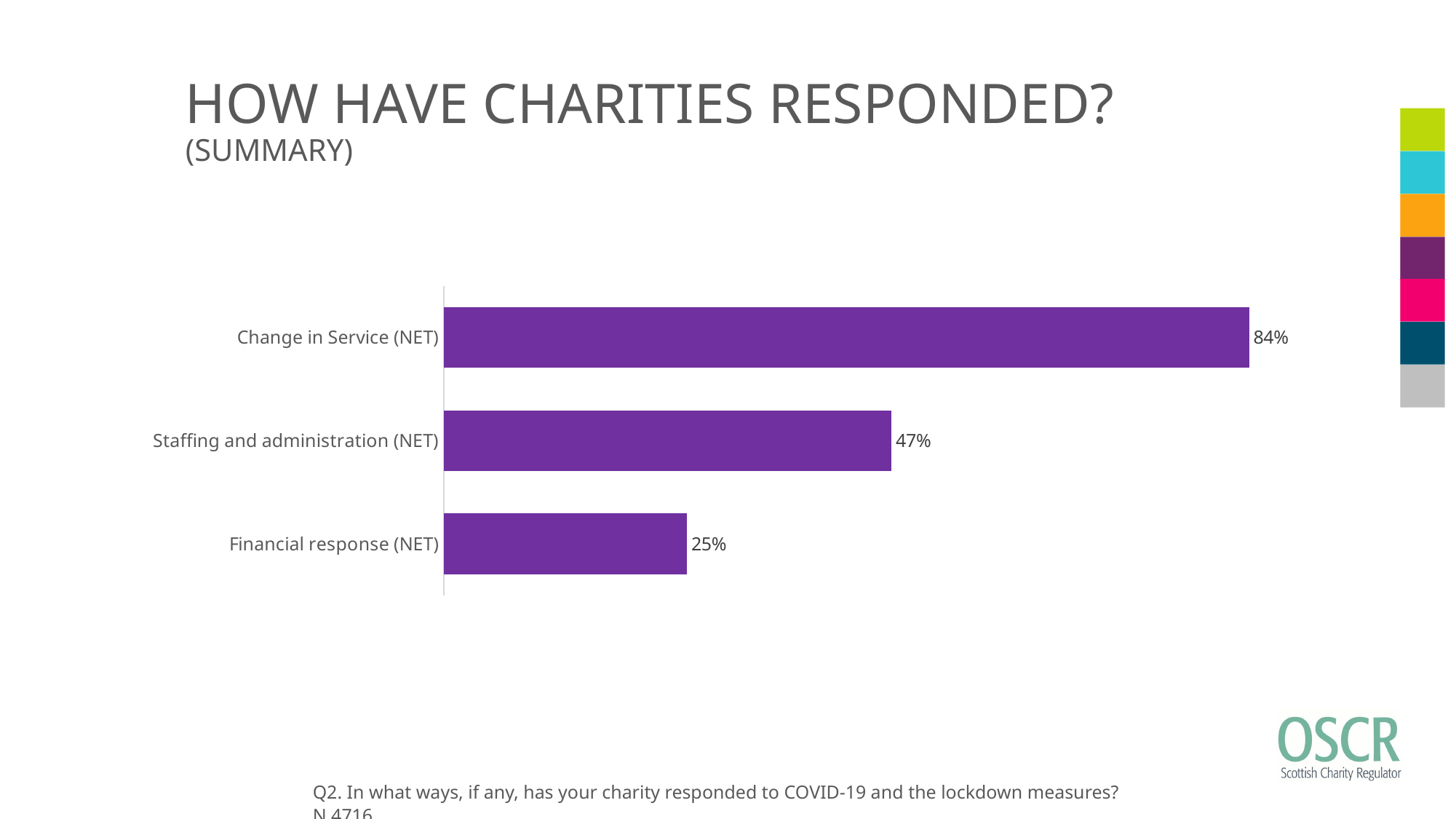
What kind of chart is shown on the slide? Bar chart What is the value for Staffing and administration (NET)? 47% Which category has the lowest value? Financial response (NET) What is the title of the slide? HOW HAVE CHARITIES RESPONDED? (SUMMARY) Which category has the highest value? Change in Service (NET) Which is larger, Staffing and administration (NET) or Financial response (NET)? Staffing and administration (NET) What is the value for Change in Service (NET)? 84% What colour are the bars in the chart? Purple What is the difference between Change in Service (NET) and Staffing and administration (NET)? 37% How many categories are shown in the chart? 3 What is the difference between Staffing and administration (NET) and Financial response (NET)? 22% What is the value for Financial response (NET)? 25%